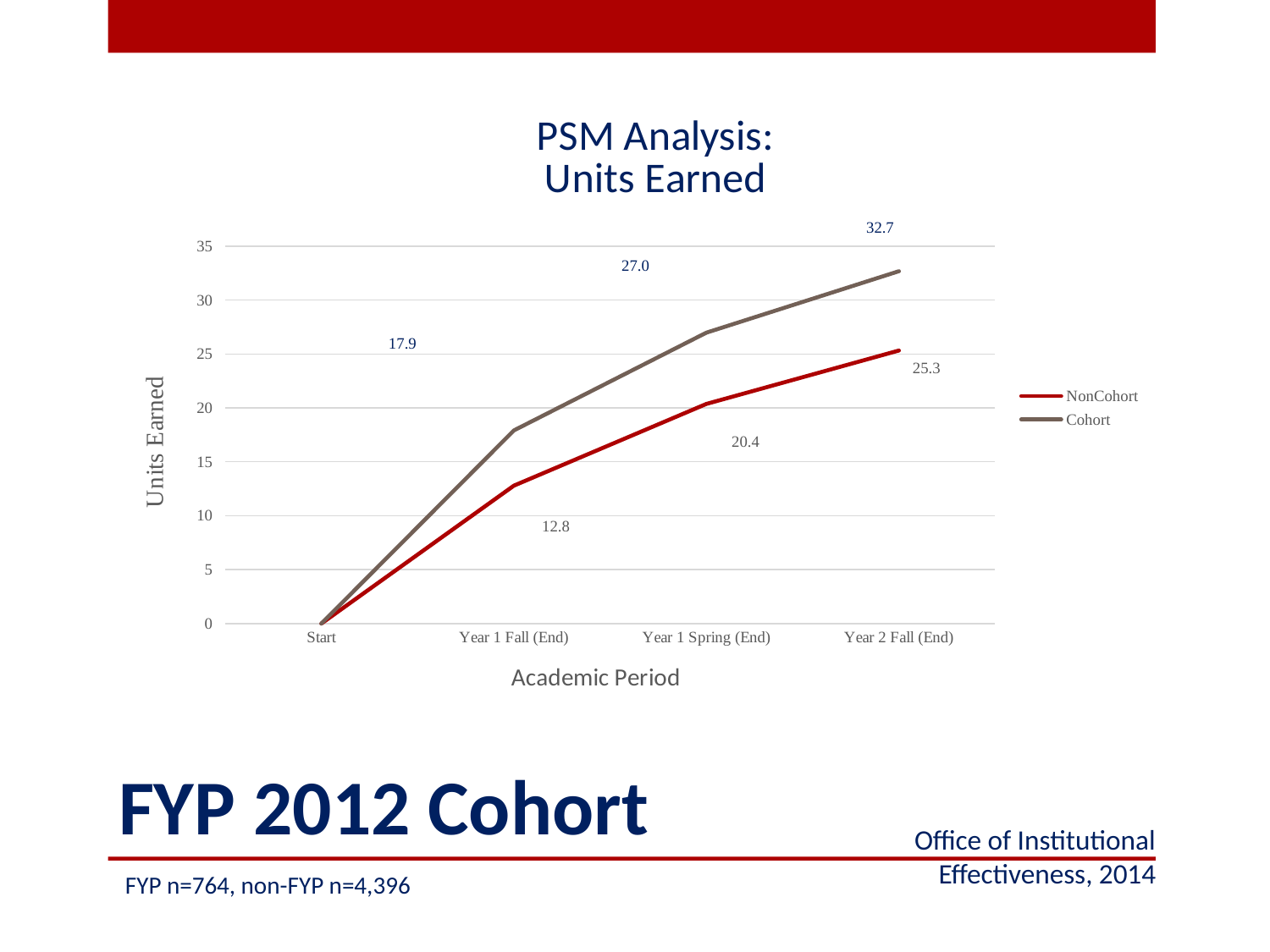
What is the NonCohort value at Year 2 Fall (End)? 25.3 At which academic period is the Cohort series highest? Year 2 Fall (End) Do the Cohort values rise or fall from Start to Year 2 Fall (End)? Rise What is the Cohort value at Year 1 Spring (End)? 27.0 How many series does the legend list? 2 How many academic periods are shown on the x axis? 4 What is the NonCohort value at Year 1 Fall (End)? 12.8 What kind of chart is shown on the slide? Line chart What is the difference between the Cohort and NonCohort values at Year 2 Fall (End)? 7.4 Which series has the larger value at Year 1 Spring (End), Cohort or NonCohort? Cohort What is the Cohort value at Year 2 Fall (End)? 32.7 At which academic period is the NonCohort series lowest? Start